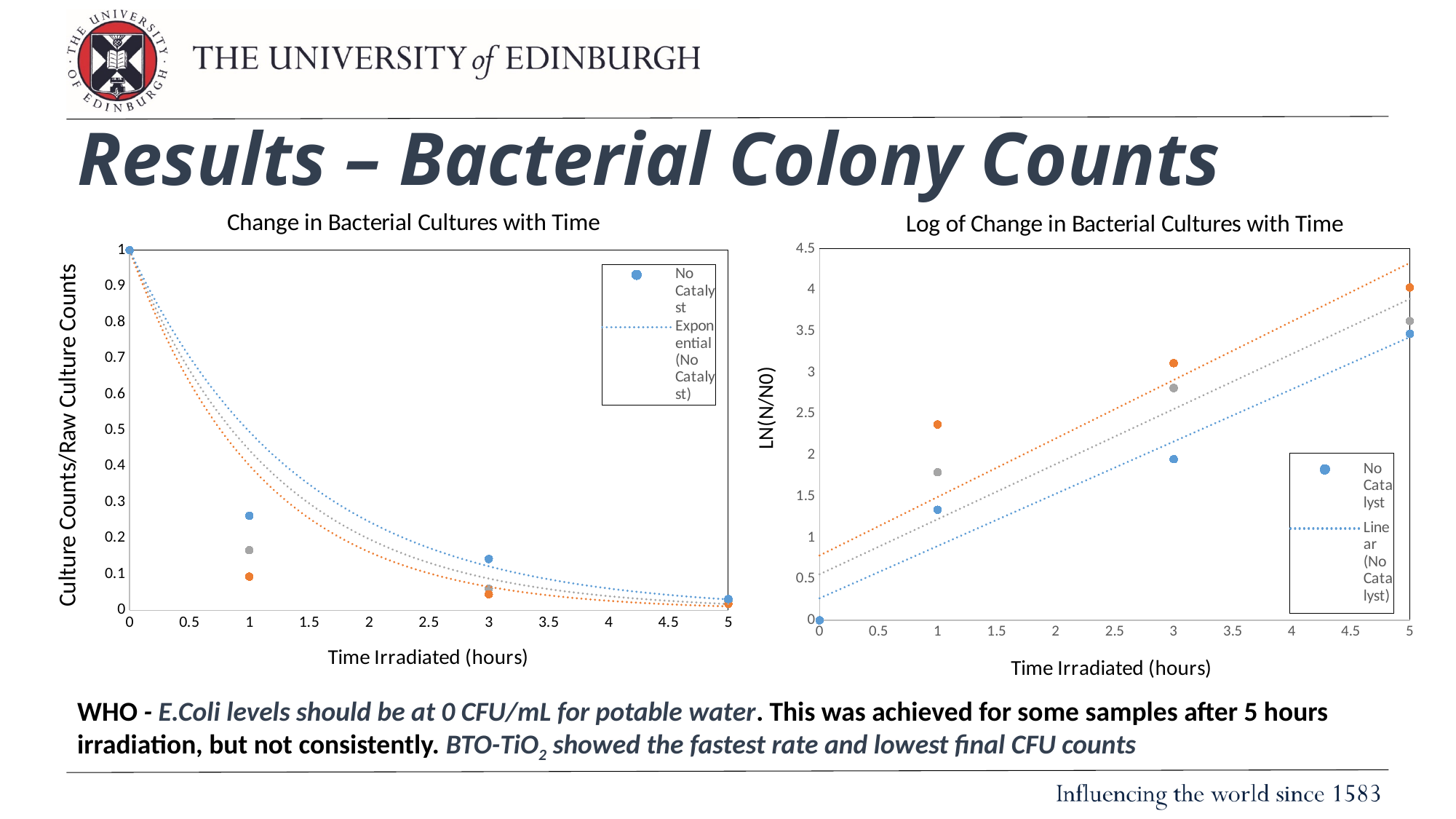
In the left chart 'Change in Bacterial Cultures with Time', is the No Catalyst value at 3 hours greater or less than 0.1? greater What type of chart is the left chart titled 'Change in Bacterial Cultures with Time'? scatter chart In the left chart 'Change in Bacterial Cultures with Time', what is the No Catalyst value at 0 hours? 1 How many entries does the legend of the right chart 'Log of Change in Bacterial Cultures with Time' list? 2 In the right chart 'Log of Change in Bacterial Cultures with Time', is the No Catalyst value at 1 hour greater or less than 1? greater In the right chart 'Log of Change in Bacterial Cultures with Time', do the No Catalyst values rise or fall as time irradiated increases? rise In the left chart 'Change in Bacterial Cultures with Time', is the No Catalyst value at 1 hour greater or less than 0.2? greater What is the title of the right chart? Log of Change in Bacterial Cultures with Time In the left chart 'Change in Bacterial Cultures with Time', what is the y-axis label? Culture Counts/Raw Culture Counts In the right chart 'Log of Change in Bacterial Cultures with Time', what is the No Catalyst value at 0 hours? 0 In the left chart 'Change in Bacterial Cultures with Time', do the No Catalyst values rise or fall as time irradiated increases? fall